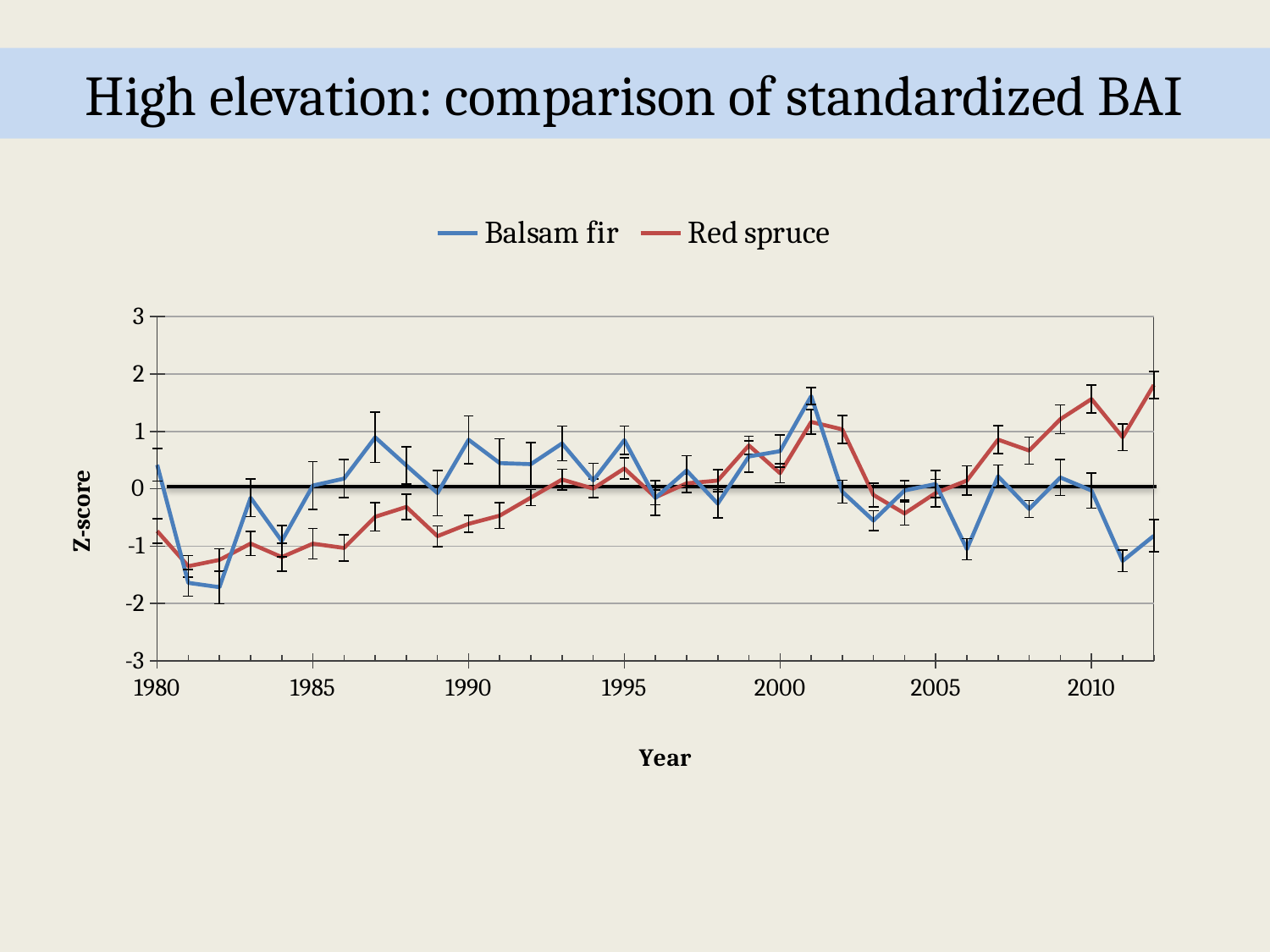
What kind of chart is shown on the slide? Line chart Does the Red spruce series generally rise or fall between 2005 and 2010? Rise How many series does the legend list? 2 What is the title of the chart on the slide? High elevation: comparison of standardized BAI Is the Red spruce value in 2012 greater or less than 1? greater In 2012, which series has the higher value, Balsam fir or Red spruce? Red spruce What is the label of the vertical axis? Z-score Is the Balsam fir value in 2001 greater or less than 1? greater Is the Balsam fir value in 1982 greater or less than -1? less In which year does the Balsam fir series reach its highest value? 2001 In 1987, which series has the higher value, Balsam fir or Red spruce? Balsam fir